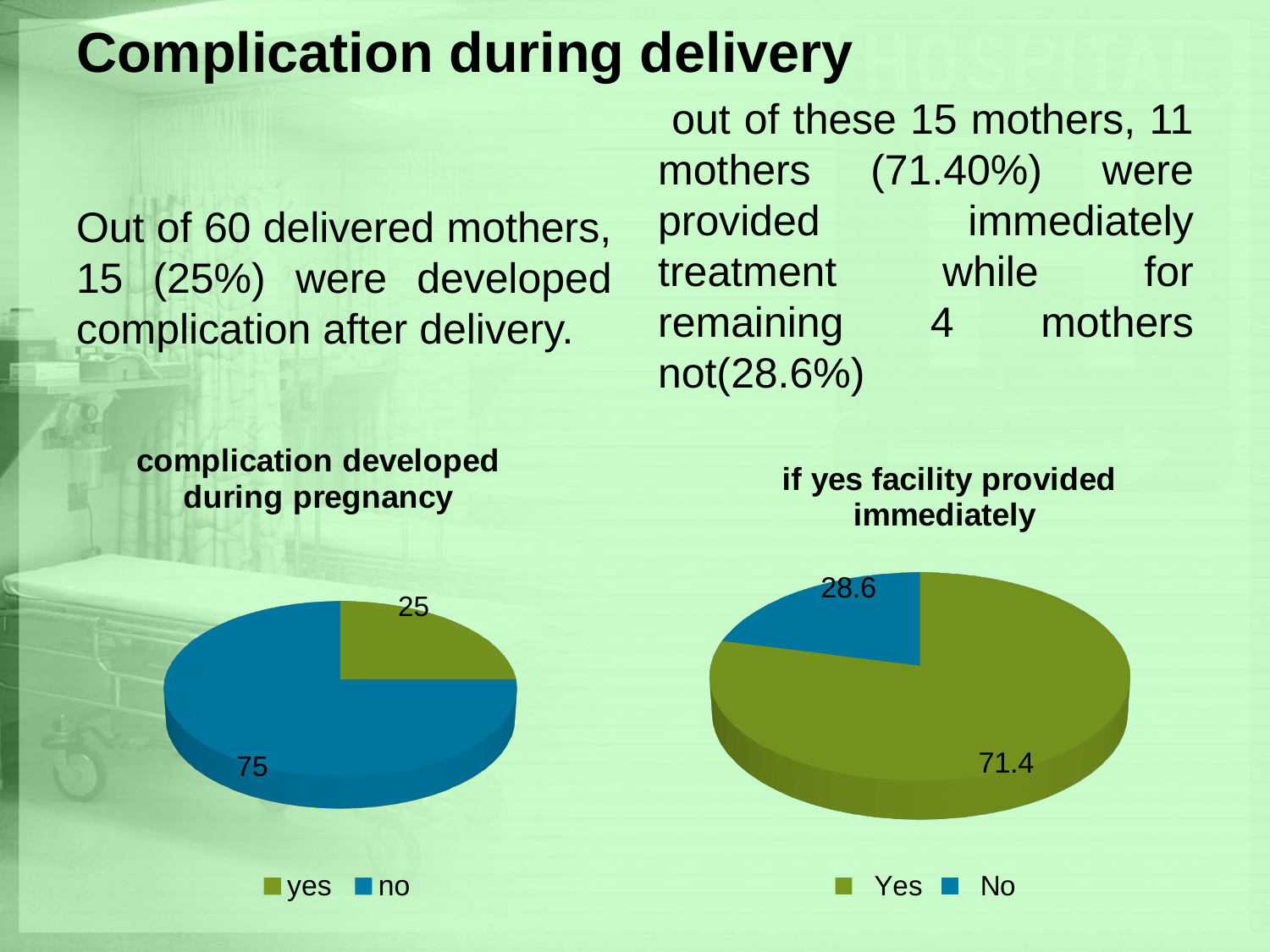
In the 'if yes facility provided immediately' chart, what is the value for 'No'? 28.6 In the 'complication developed during pregnancy' chart, what is the value for 'no'? 75 What type of chart is the 'complication developed during pregnancy' chart? Pie chart How many categories does the 'if yes facility provided immediately' chart show? 2 In the 'if yes facility provided immediately' chart, which category has the smallest slice? No In the 'if yes facility provided immediately' chart, what is the value for 'Yes'? 71.4 In the 'if yes facility provided immediately' chart, what is the difference between the 'Yes' and 'No' values? 42.8 In the 'complication developed during pregnancy' chart, what colour is the 'no' slice? Blue In the 'complication developed during pregnancy' chart, which category has the largest slice? no In the 'complication developed during pregnancy' chart, what is the difference between the 'no' and 'yes' values? 50 In the 'complication developed during pregnancy' chart, what is the value for 'yes'? 25 In the 'if yes facility provided immediately' chart, which is larger, 'Yes' or 'No'? Yes